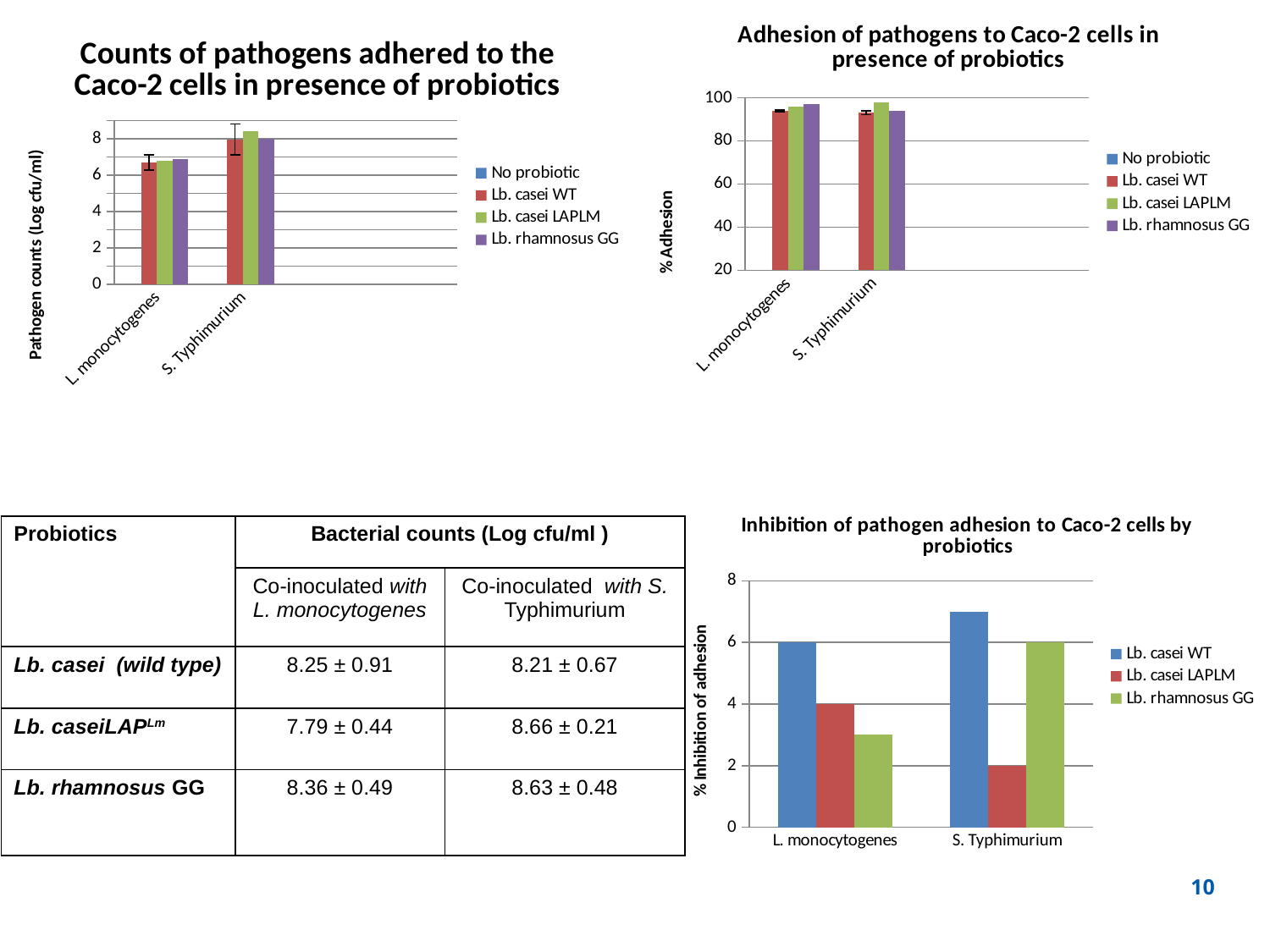
In the 'Inhibition of pathogen adhesion to Caco-2 cells by probiotics' chart, how many series does the legend list? 3 In the 'Adhesion of pathogens to Caco-2 cells in presence of probiotics' chart, is the % adhesion for Lb. casei WT with L. monocytogenes greater or less than 80? greater In the 'Inhibition of pathogen adhesion to Caco-2 cells by probiotics' chart, is the value for Lb. casei WT with S. Typhimurium greater or less than 6? greater What kind of chart is the bottom-right chart titled 'Inhibition of pathogen adhesion to Caco-2 cells by probiotics'? bar chart In the 'Inhibition of pathogen adhesion to Caco-2 cells by probiotics' chart, what is the % inhibition of adhesion for Lb. casei WT with L. monocytogenes? 6 In the 'Inhibition of pathogen adhesion to Caco-2 cells by probiotics' chart, is the value for Lb. rhamnosus GG with L. monocytogenes greater or less than 4? less In the 'Counts of pathogens adhered to the Caco-2 cells in presence of probiotics' chart, is the Lb. casei LAPLM value larger for L. monocytogenes or for S. Typhimurium? S. Typhimurium In the 'Inhibition of pathogen adhesion to Caco-2 cells by probiotics' chart, which probiotic shows the lowest % inhibition of adhesion for S. Typhimurium? Lb. casei LAPLM In the 'Inhibition of pathogen adhesion to Caco-2 cells by probiotics' chart, what is the % inhibition of adhesion for Lb. casei LAPLM with S. Typhimurium? 2 In the 'Inhibition of pathogen adhesion to Caco-2 cells by probiotics' chart, what is the difference between the Lb. casei WT and Lb. casei LAPLM values for L. monocytogenes? 2 In the 'Counts of pathogens adhered to the Caco-2 cells in presence of probiotics' chart, how many series does the legend list? 4 In the 'Inhibition of pathogen adhesion to Caco-2 cells by probiotics' chart, what is the % inhibition of adhesion for Lb. rhamnosus GG with S. Typhimurium? 6